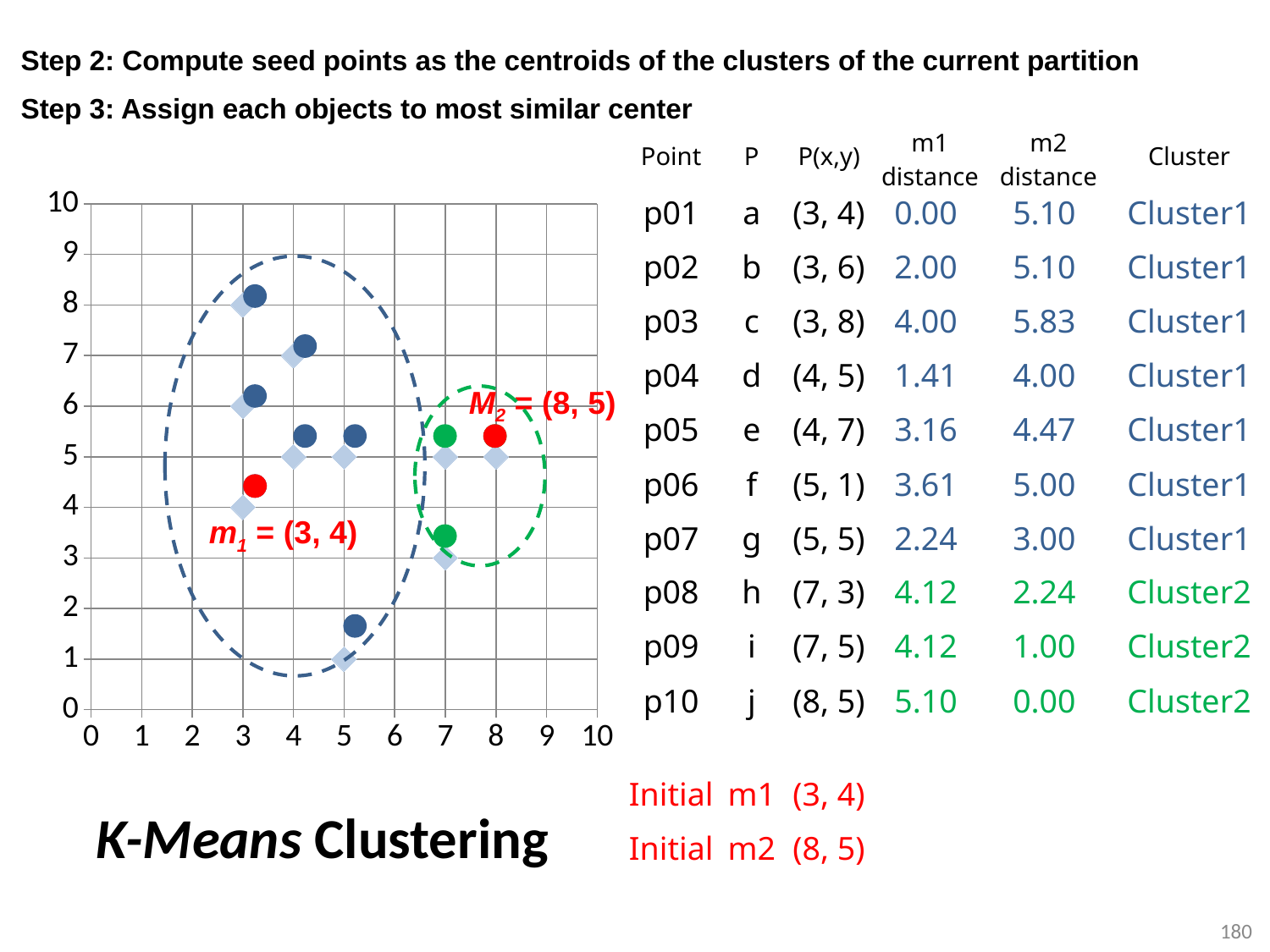
What is the lowest y value reached by any plotted data point? 1 What coordinates are given for the centroid labelled M2 on the chart? (8, 5) How many data points lie inside the green dashed ellipse? 3 How many data points lie inside the blue dashed ellipse? 7 What kind of chart is shown on the slide? scatter chart What coordinates are given for the centroid labelled m1 on the chart? (3, 4) Which centroid has the larger x coordinate, m1 or M2? M2 What colour is the dashed ellipse drawn around the centroid M2? green Is the x coordinate of the centroid M2 greater or less than 5? greater What is the maximum value shown on the x axis? 10 What is the difference between the x coordinates of M2 and m1? 5 What is the highest y value reached by any plotted data point? 8